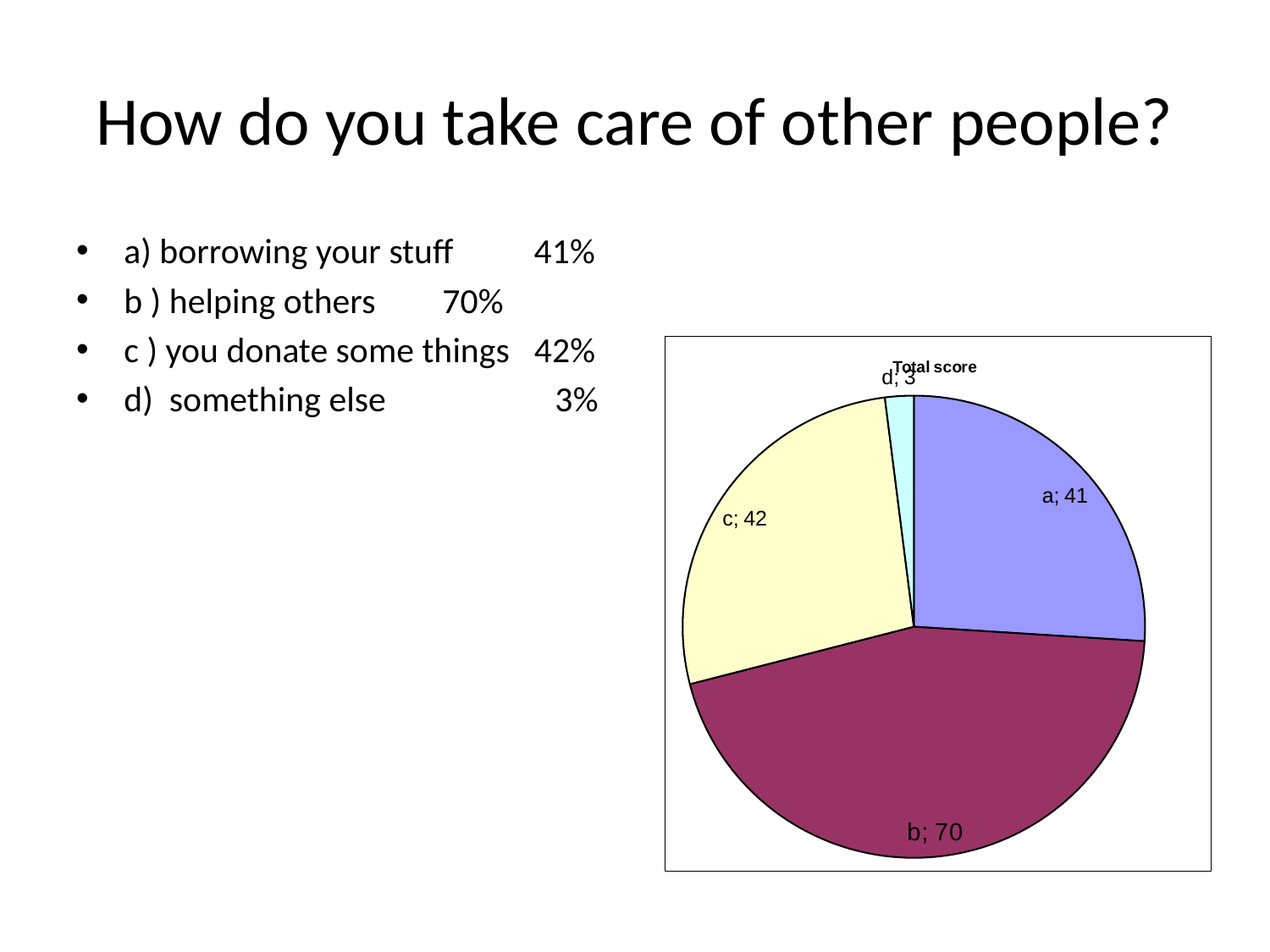
Which slice of the pie chart has the largest value? b Which slice of the pie chart has the smallest value? d What is the value of slice a in the pie chart? 41 What is the value of slice c in the pie chart? 42 In the pie chart, which slice has the larger value, b or c? b What is the value of slice d in the pie chart? 3 What is the difference between the values of slices b and a in the pie chart? 29 How many slices does the pie chart have? 4 What type of chart is shown on the slide? pie chart What is the value of slice b in the pie chart? 70 What is the title of the chart on the slide? Total score What is the difference between the values of slices c and d in the pie chart? 39